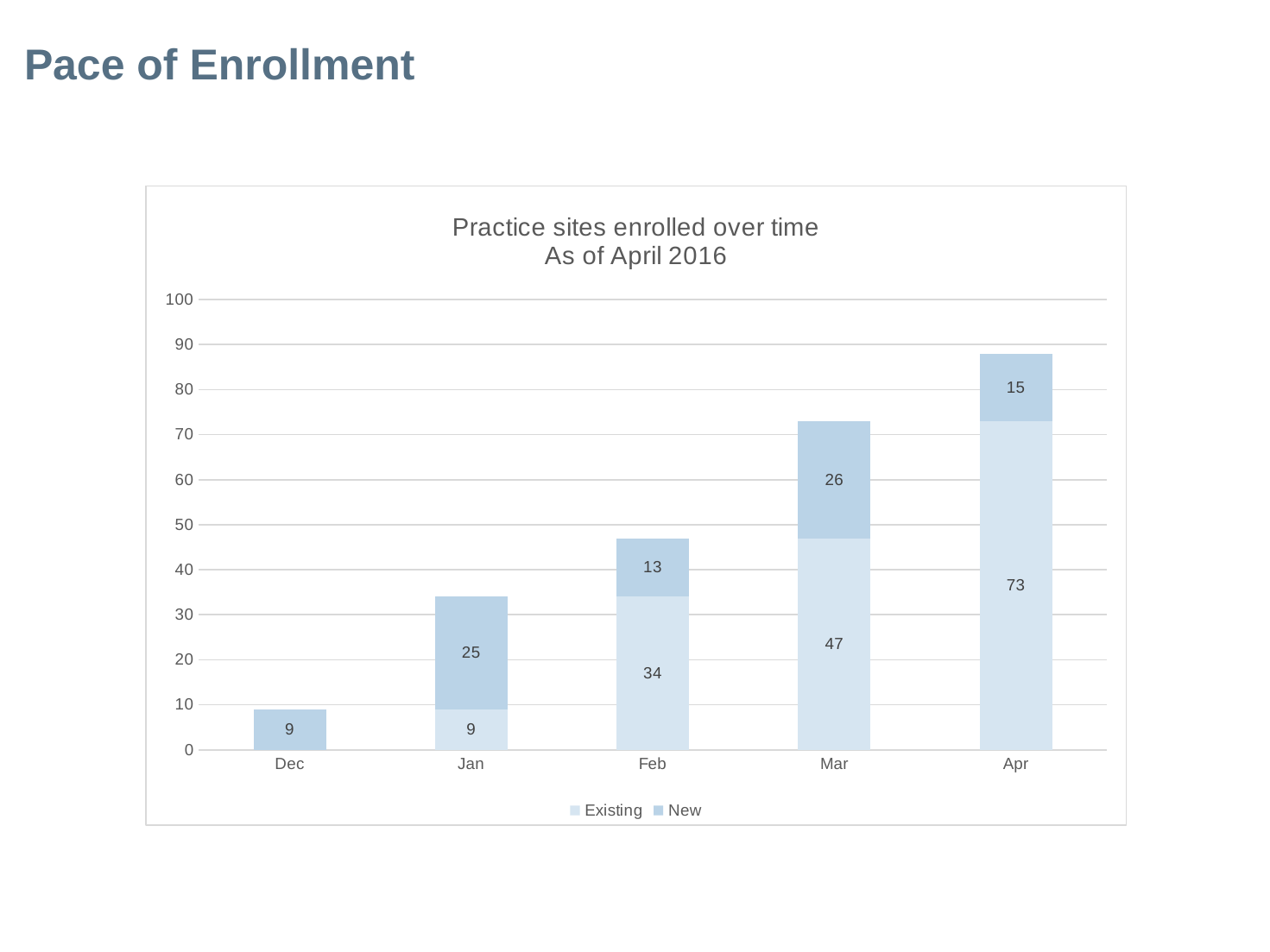
How many series does the legend list? 2 How many months are shown on the x axis? 5 What is the New value for Mar? 26 What kind of chart is shown on the slide? stacked bar chart Which is larger, the New value for Feb or the New value for Apr? Apr What is the Existing value for Apr? 73 Which month has the highest New value? Mar What is the New value for Jan? 25 What is the difference between the Existing values for Apr and Mar? 26 What is the Existing value for Feb? 34 What is the total of the stacked bar for Mar? 73 Which month has the lowest Existing value among the months where Existing is labelled? Jan